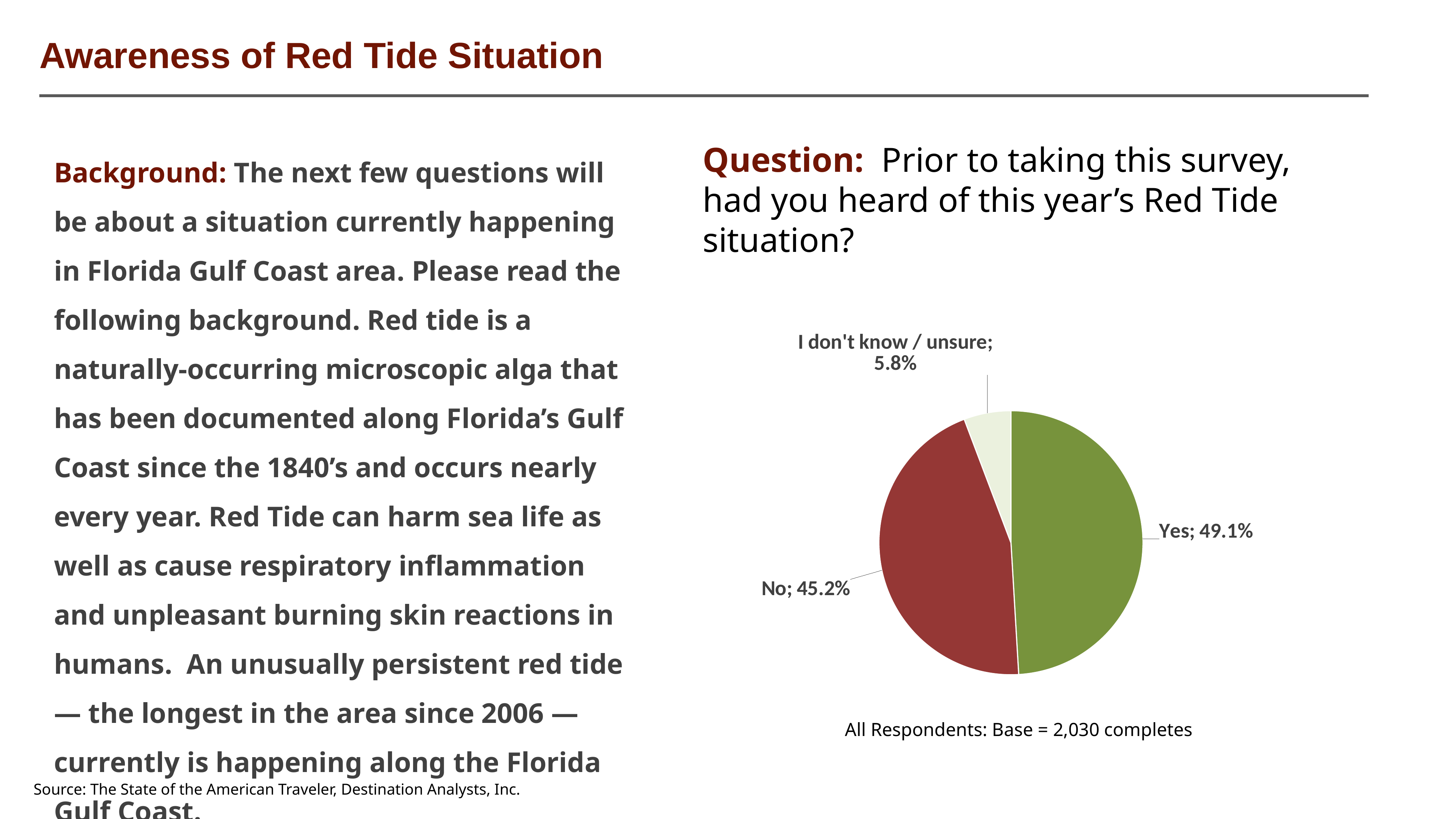
Which slice is larger, "No" or "I don't know / unsure"? No What type of chart is shown on the slide? Pie chart What is the base number of completes stated below the chart? 2,030 Which response has the smallest share of the pie? I don't know / unsure Which response has the largest share of the pie? Yes What percentage of respondents answered "No"? 45.2% What percentage of respondents answered "Yes" to having heard of this year's Red Tide situation? 49.1% What colour is the "Yes" slice of the pie chart? Green What percentage of respondents answered "I don't know / unsure"? 5.8% What is the difference in percentage points between the "Yes" and "No" slices? 3.9 How many slices does the pie chart have? 3